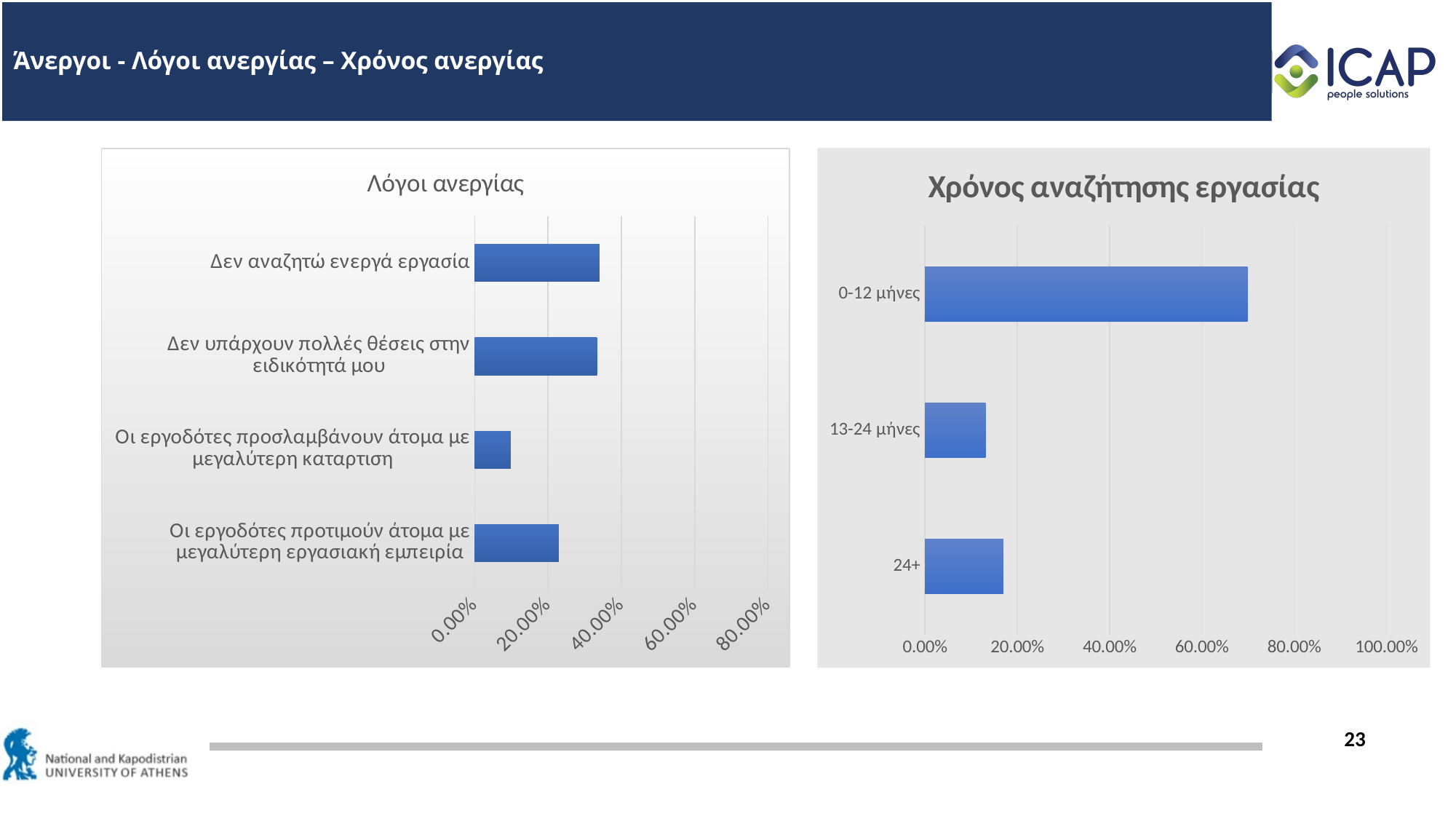
How many categories are shown in the 'Λόγοι ανεργίας' chart? 4 In the 'Λόγοι ανεργίας' chart, which is larger: 'Οι εργοδότες προτιμούν άτομα με μεγαλύτερη εργασιακή εμπειρία' or 'Οι εργοδότες προσλαμβάνουν άτομα με μεγαλύτερη καταρτιση'? Οι εργοδότες προτιμούν άτομα με μεγαλύτερη εργασιακή εμπειρία In the 'Λόγοι ανεργίας' chart, is the value for 'Δεν αναζητώ ενεργά εργασία' greater or less than 20.00%? greater What type of chart is the 'Λόγοι ανεργίας' chart on the left? bar chart What is the title of the chart on the right side of the slide? Χρόνος αναζήτησης εργασίας In the 'Χρόνος αναζήτησης εργασίας' chart, is the value for '0-12 μήνες' greater or less than 60.00%? greater In the 'Χρόνος αναζήτησης εργασίας' chart, which is larger: '13-24 μήνες' or '24+'? 24+ How many categories are shown in the 'Χρόνος αναζήτησης εργασίας' chart? 3 In the 'Λόγοι ανεργίας' chart, which category has the lowest value? Οι εργοδότες προσλαμβάνουν άτομα με μεγαλύτερη καταρτιση In the 'Χρόνος αναζήτησης εργασίας' chart, which category has the highest value? 0-12 μήνες In the 'Χρόνος αναζήτησης εργασίας' chart, is the value for '13-24 μήνες' greater or less than 20.00%? less